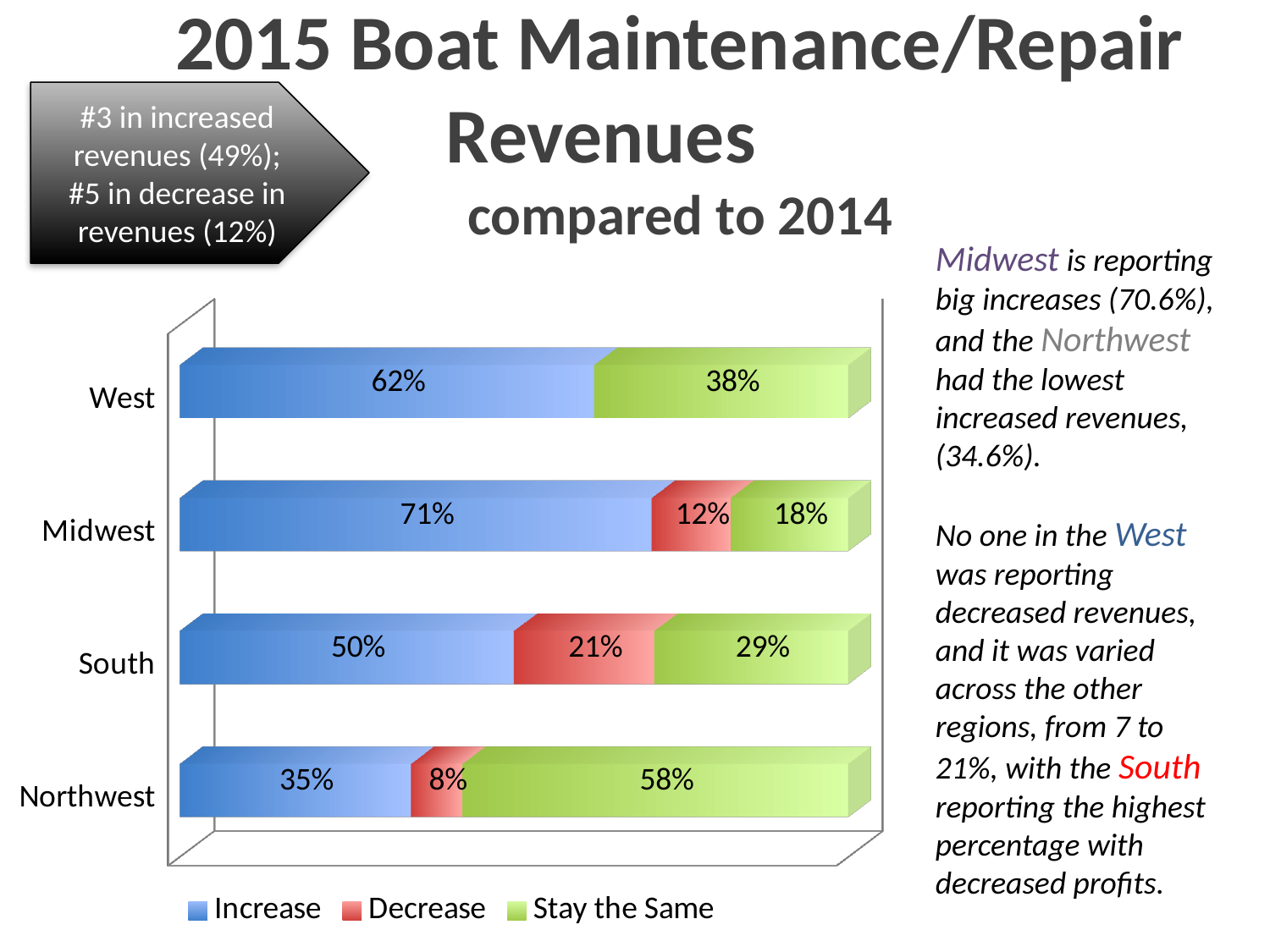
What kind of chart is shown on the slide? Stacked bar chart What percentage of the Northwest region reported revenues staying the same? 58% Which series is shown in red in the legend? Decrease What percentage of the West region reported an increase in revenues? 62% Which is larger, the Stay the Same percentage for the West or for the South? West How many regions are shown in the chart? 4 How many series does the legend list? 3 What is the difference between the Midwest and Northwest percentages for Increase? 36% Which region has the highest percentage reporting an increase in revenues? Midwest Which region has the lowest percentage reporting an increase in revenues? Northwest What percentage of the South region reported a decrease in revenues? 21%